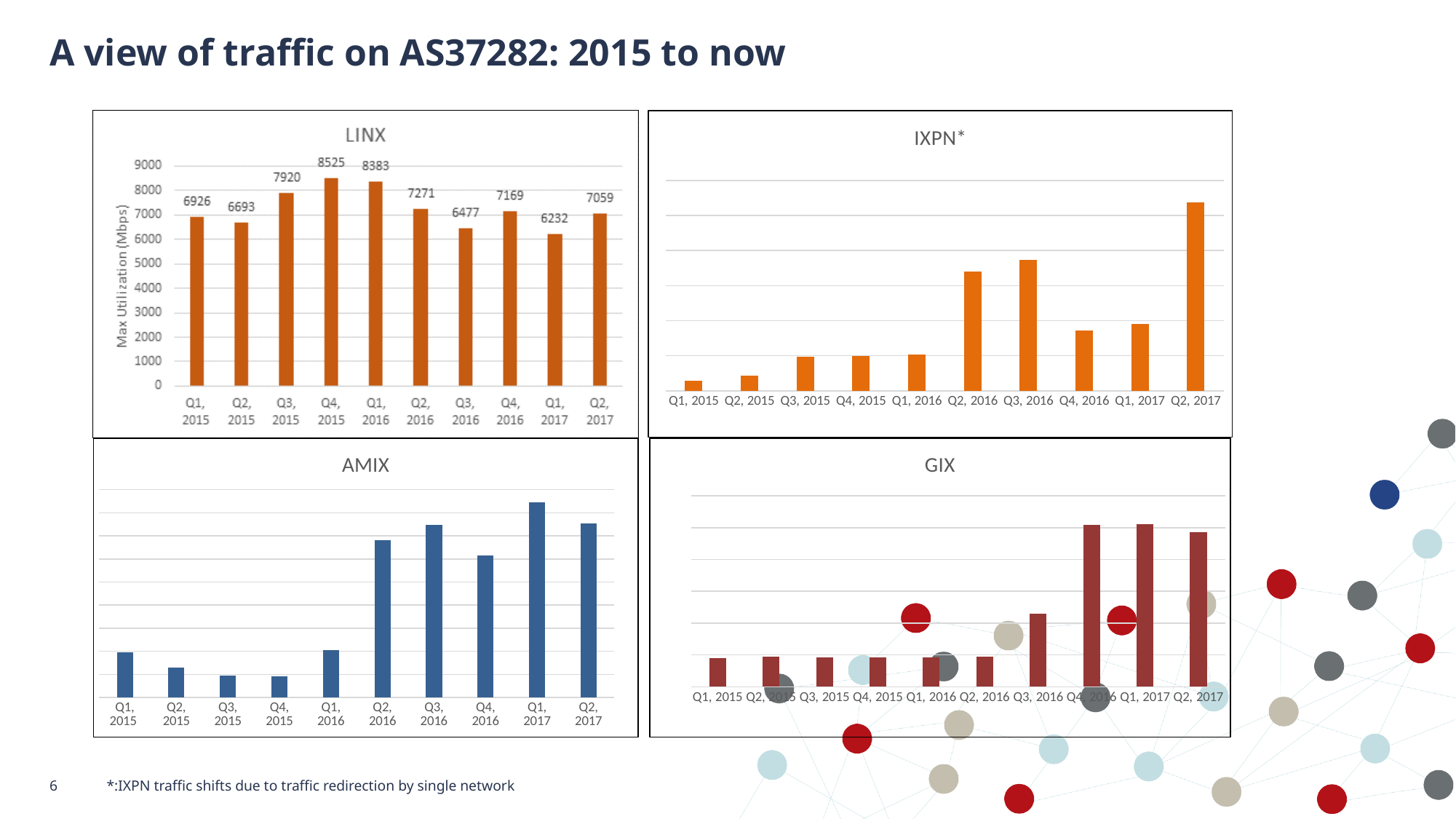
In the LINX chart, which is larger: the value for Q3, 2015 or the value for Q2, 2016? Q3, 2015 In the GIX chart, which is larger: the bar for Q3, 2016 or the bar for Q2, 2016? Q3, 2016 In the AMIX chart, which quarter has the highest bar? Q1, 2017 In the LINX chart, which quarter has the lowest value? Q1, 2017 In the IXPN* chart, which quarter has the lowest bar? Q1, 2015 How many quarters are shown on the x axis of the AMIX chart? 10 In the LINX chart, what is the difference between the values for Q4, 2015 and Q1, 2017? 2293 In the LINX chart, what is the value for Q4, 2015? 8525 In the LINX chart, which quarter has the highest value? Q4, 2015 In the IXPN* chart, which quarter has the highest bar? Q2, 2017 In the LINX chart, what is the value for Q1, 2017? 6232 In the LINX chart, is the value for Q3, 2016 greater or less than 7000? less